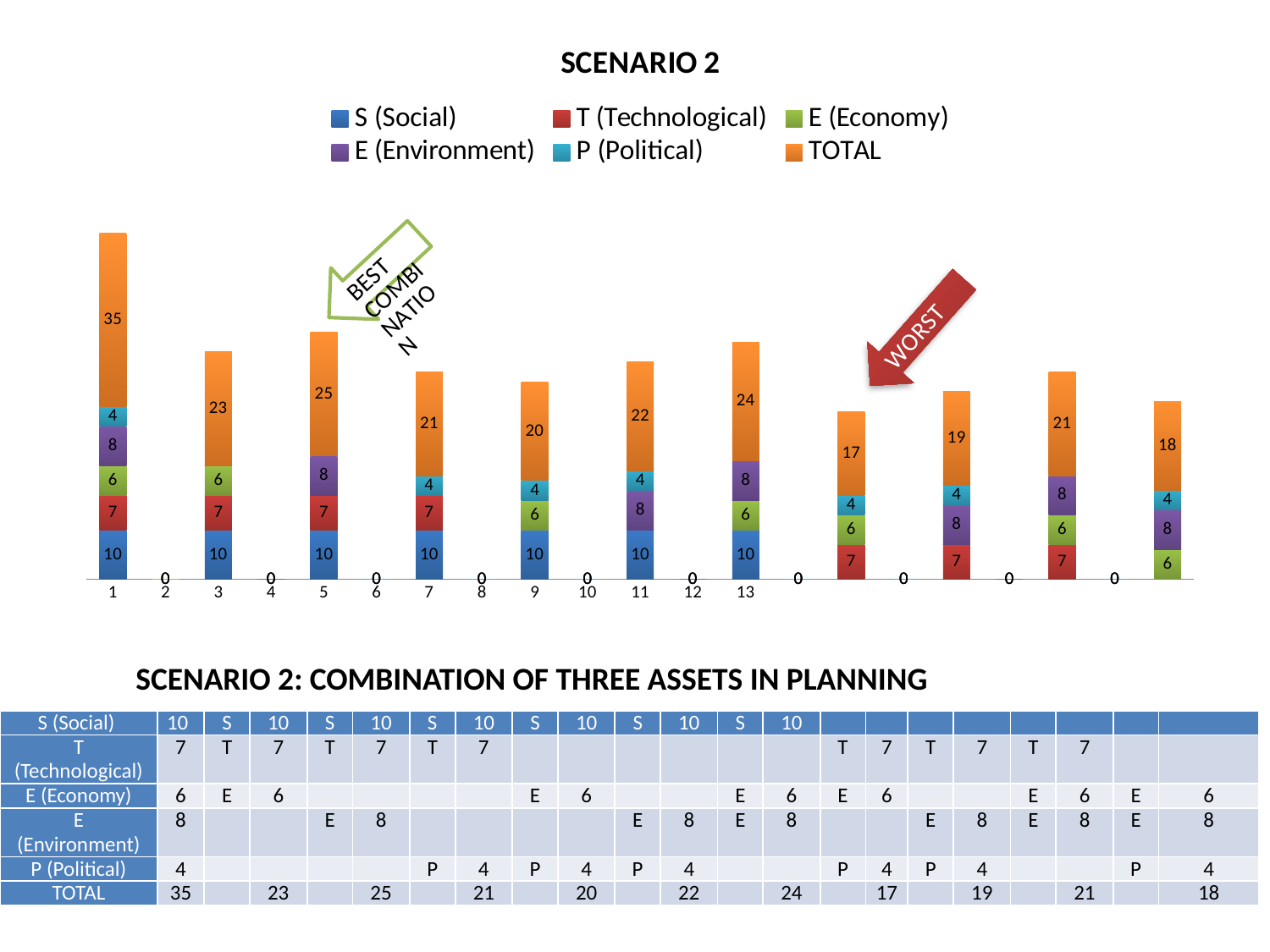
Among categories 1 to 13, which has the lowest TOTAL value? 9 What is the TOTAL value for category 5? 25 What is the S (Social) value for category 3? 10 What is the TOTAL value for category 1? 35 What is the difference between the TOTAL values for category 1 and category 3? 12 How many series does the legend list? 6 What is the title of the chart? SCENARIO 2 What kind of chart is shown? Stacked bar chart Which category has the highest TOTAL value? 1 Which has a larger TOTAL value, category 5 or category 7? 5 What is the P (Political) value for category 7? 4 What is the E (Environment) value for category 11? 8